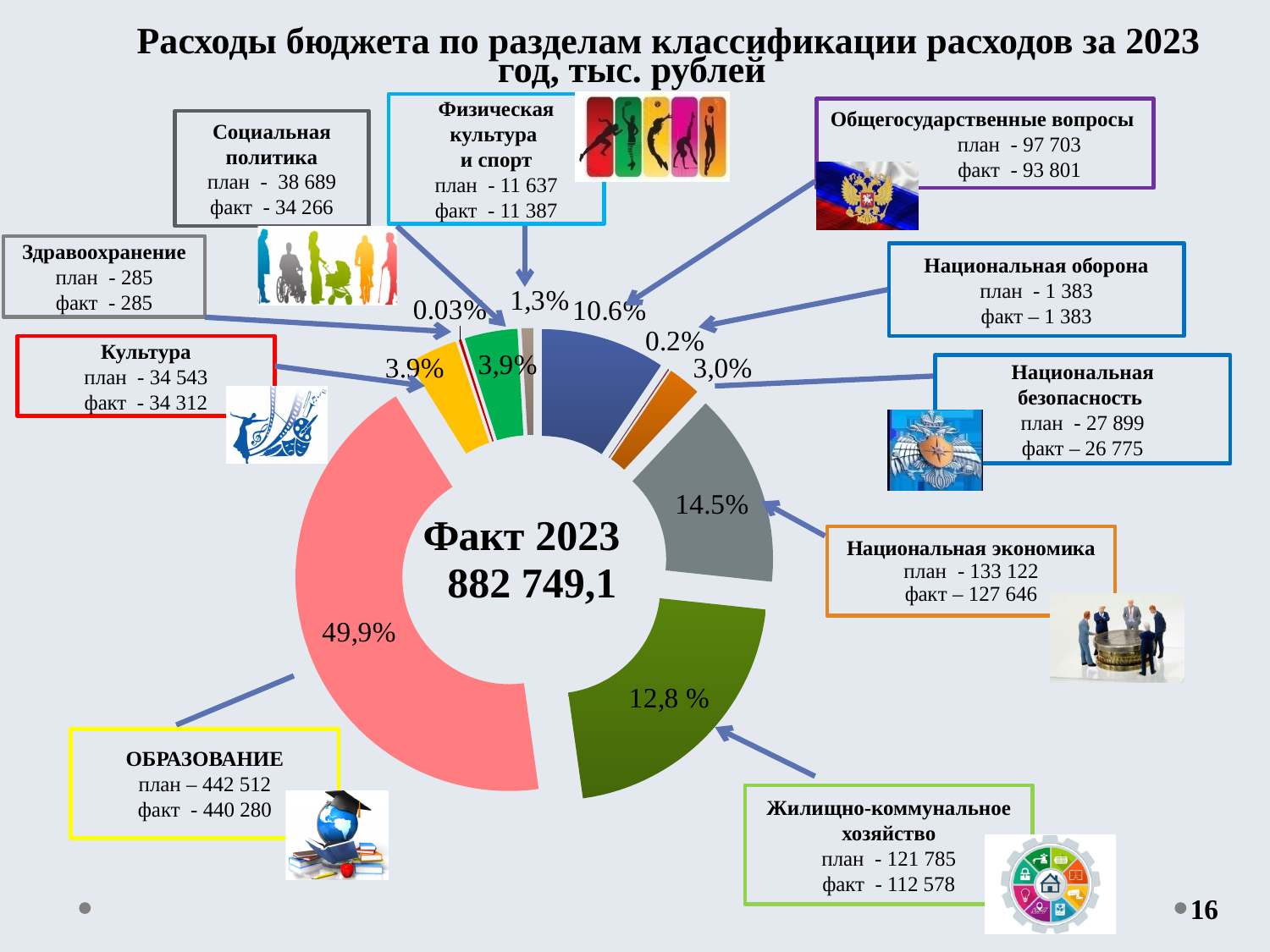
Which section has the largest slice of the pie? ОБРАЗОВАНИЕ What kind of chart is shown on the slide? Pie (donut) chart What share of the pie does the Жилищно-коммунальное хозяйство slice have? 12,8 % What share of the pie does the Национальная экономика slice have? 14.5% What share of the pie does the Общегосударственные вопросы slice have? 10.6% What is the fact value for Национальная экономика? 127 646 Which section has the smallest slice of the pie? Здравоохранение What is the difference between the plan and fact values for Жилищно-коммунальное хозяйство? 9 207 What is the total fact value for 2023 shown in the centre of the chart? 882 749,1 What is the plan value for ОБРАЗОВАНИЕ? 442 512 Which slice is larger: Национальная экономика or Жилищно-коммунальное хозяйство? Национальная экономика